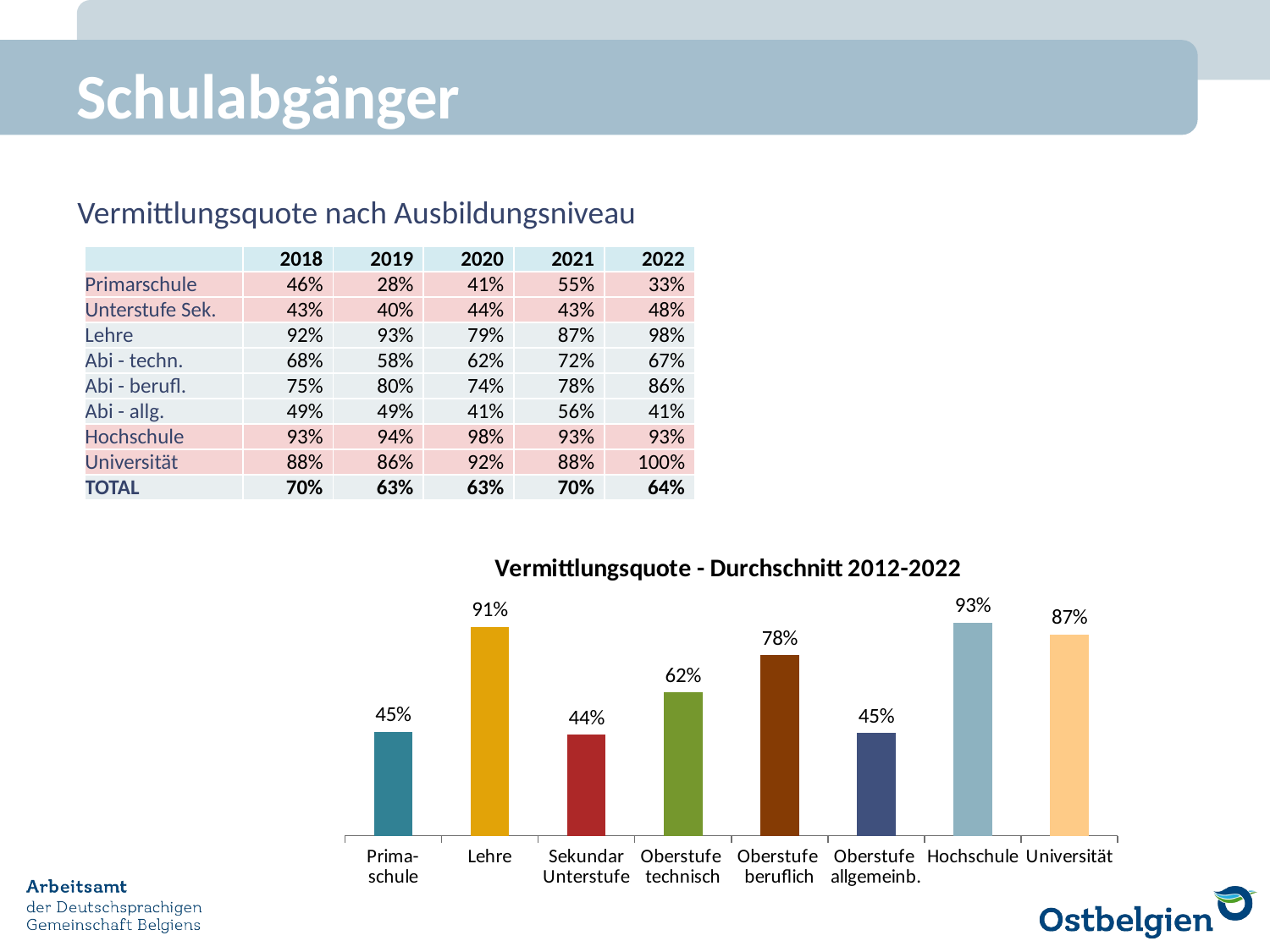
Which is larger, the value for Universität or the value for Oberstufe technisch? Universität How many categories are shown in the chart? 8 Which category has the highest value in the chart? Hochschule What is the value for Lehre in the chart 'Vermittlungsquote - Durchschnitt 2012-2022'? 91% What is the value for Oberstufe beruflich in the chart? 78% What kind of chart is shown on the slide? Bar chart Which is larger, the value for Oberstufe beruflich or the value for Oberstufe allgemeinb.? Oberstufe beruflich What is the value for Sekundar Unterstufe in the chart? 44% What is the title of the chart on the slide? Vermittlungsquote - Durchschnitt 2012-2022 What is the difference between the values for Lehre and Primaschule? 46% What is the difference between the values for Universität and Oberstufe technisch? 25% What is the value for Hochschule in the chart? 93%